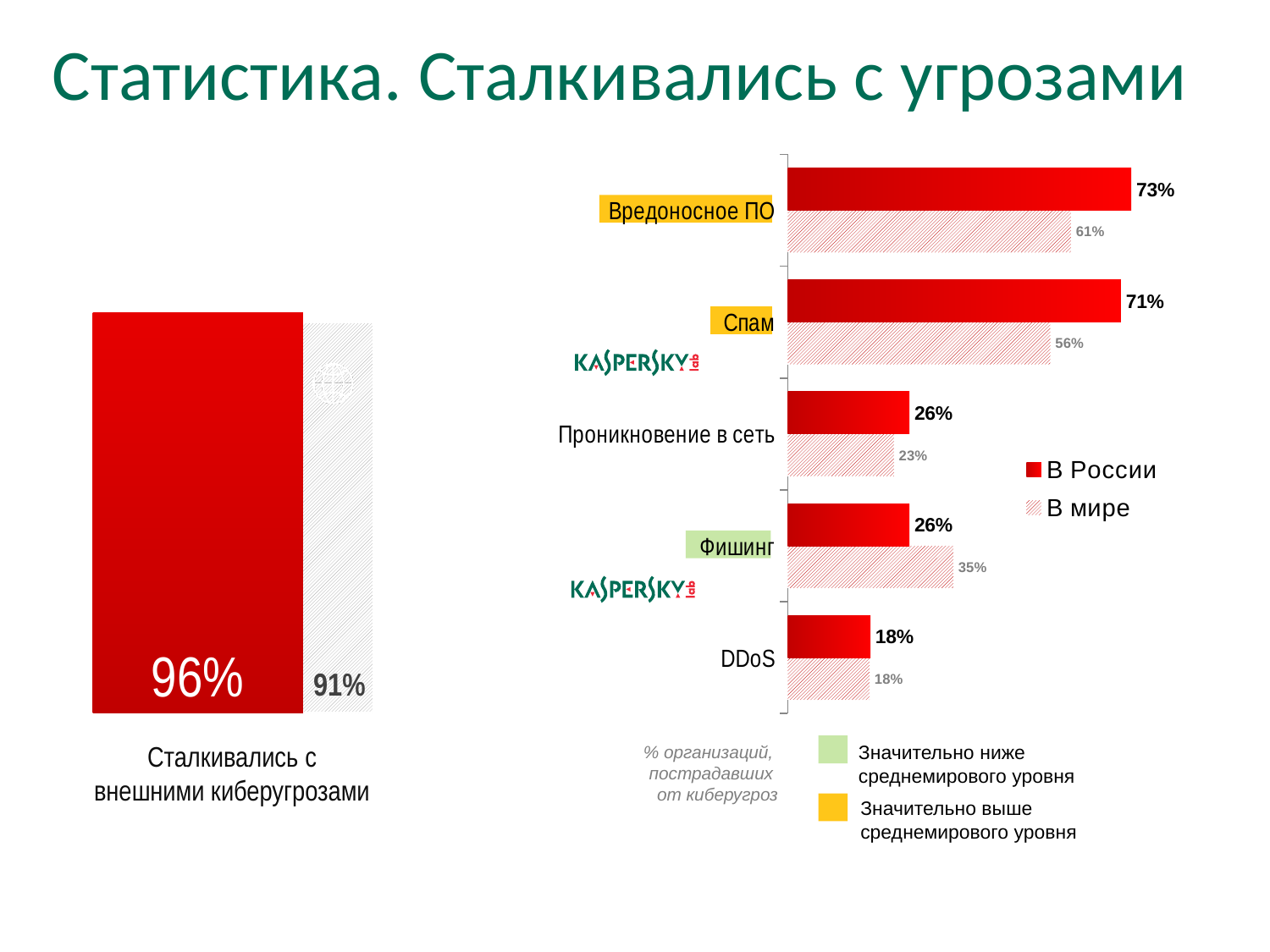
How many series does the legend of the right-hand bar chart list? 2 In the right-hand bar chart, which is larger for Фишинг: the В России value or the В мире value? В мире In the left-hand chart (Сталкивались с внешними киберугрозами), what is the value of the red bar? 96% In the right-hand bar chart, what is the difference between the В России and В мире values for Спам? 15% In the right-hand bar chart, what is the value for Спам in the В мире series? 56% In the right-hand bar chart, which category has the lowest value in the В мире series? DDoS In the right-hand bar chart, what is the value for Вредоносное ПО in the В России series? 73% In the right-hand bar chart, what is the value for Фишинг in the В мире series? 35% What kind of chart is the chart on the right of the slide? Bar chart In the right-hand bar chart, which category has the highest value in the В России series? Вредоносное ПО In the left-hand chart (Сталкивались с внешними киберугрозами), what is the difference between the two bars? 5% How many categories does the right-hand bar chart show? 5